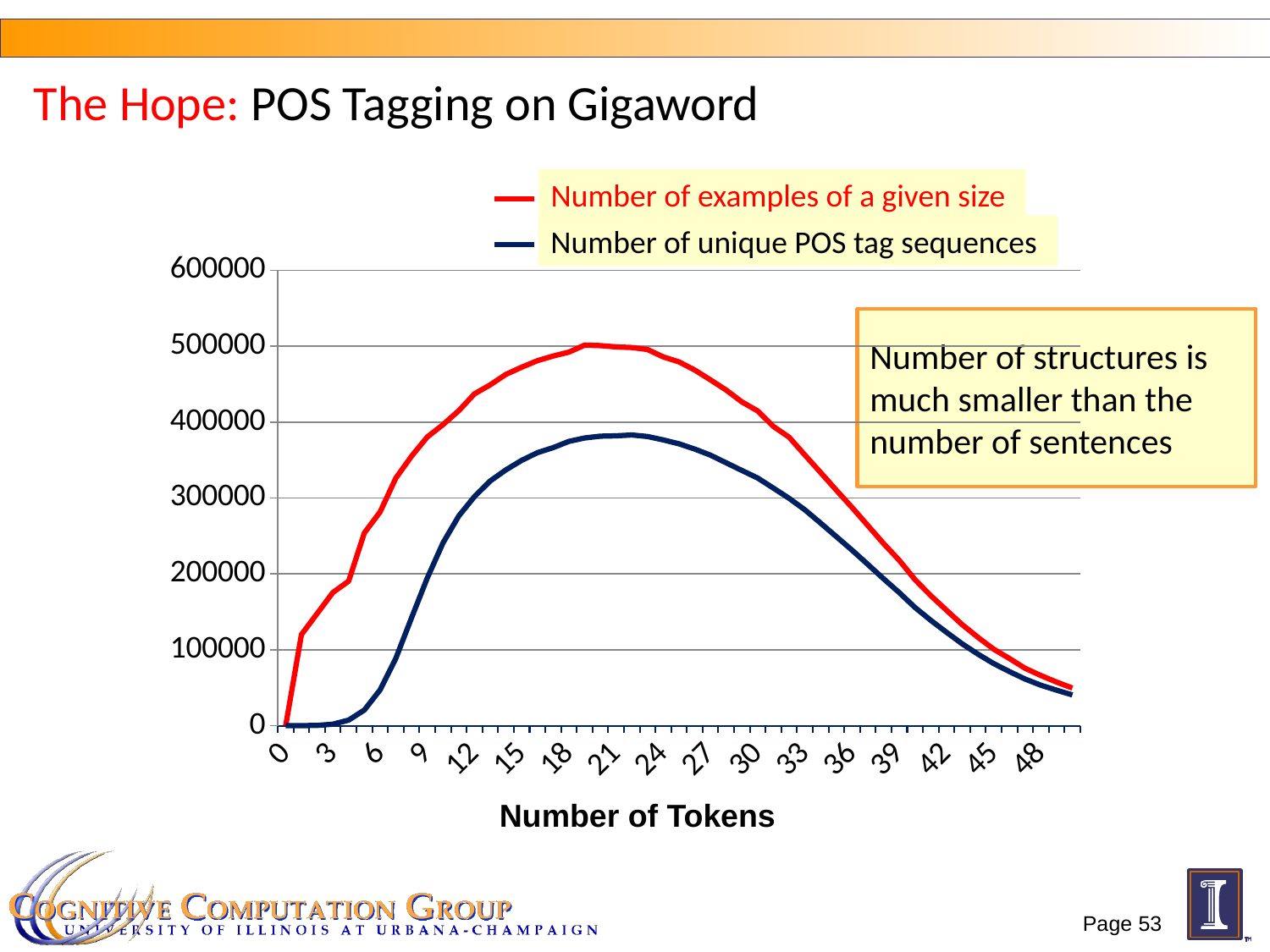
At 21 tokens, which series has the larger value: 'Number of examples of a given size' or 'Number of unique POS tag sequences'? Number of examples of a given size What kind of chart is shown on the slide? line chart Does the 'Number of unique POS tag sequences' series rise or fall from 6 tokens to 18 tokens? rise Is the value of 'Number of unique POS tag sequences' at 21 tokens greater or less than 400000? less What is the title of the x axis? Number of Tokens How many series does the legend list? 2 Is the value of 'Number of examples of a given size' at 9 tokens greater or less than 300000? greater Is the value of 'Number of examples of a given size' at 30 tokens greater or less than 400000? greater Which series is drawn in red? Number of examples of a given size Does the 'Number of examples of a given size' series rise or fall from 24 tokens to 48 tokens? fall